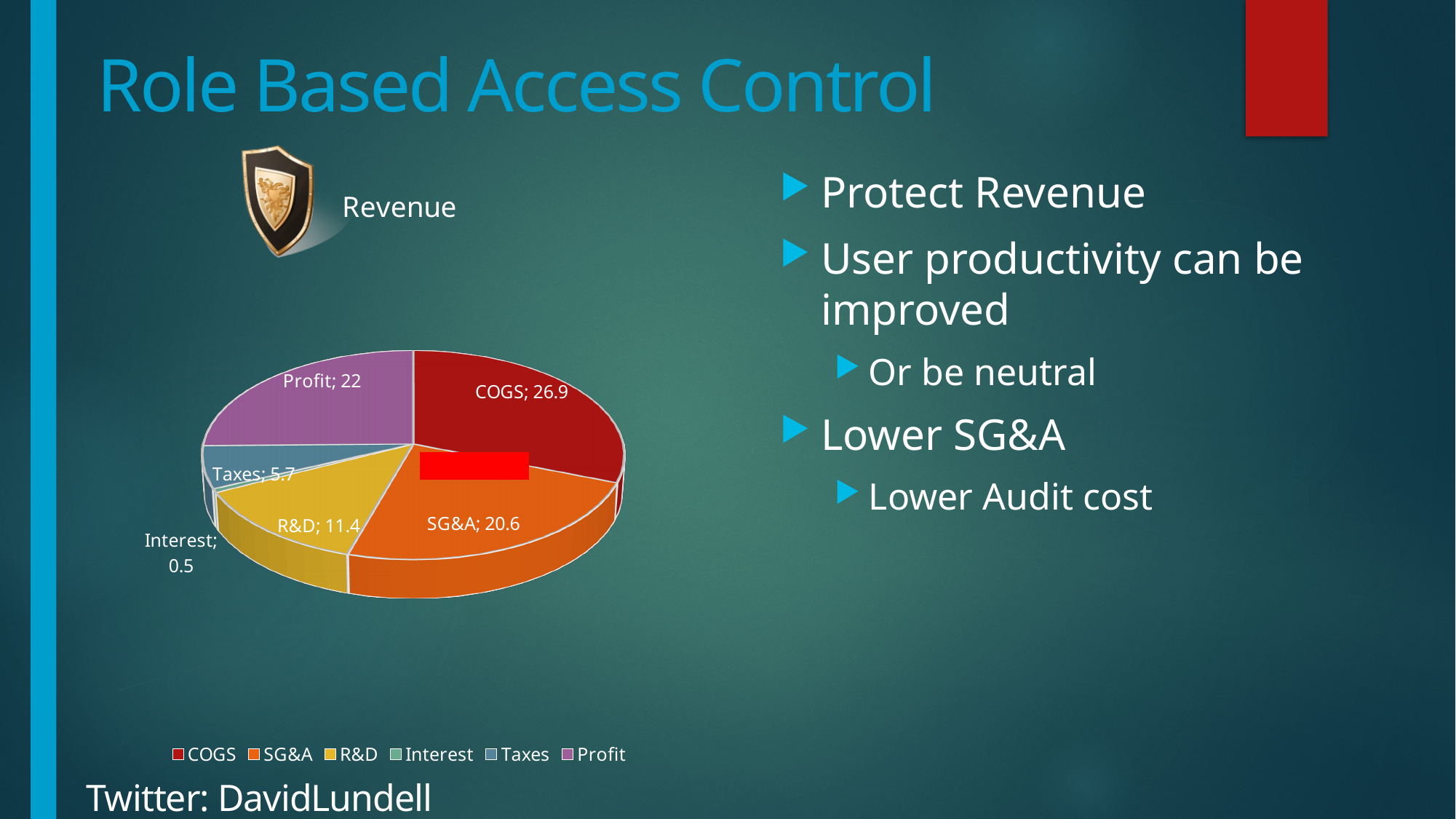
Which is larger in the Revenue pie chart, R&D or Taxes? R&D How many entries does the legend of the Revenue pie chart list? 6 What is the value of the Profit slice in the Revenue pie chart? 22 What is the value of the SG&A slice in the Revenue pie chart? 20.6 What is the difference between the COGS and SG&A values in the Revenue pie chart? 6.3 How many slices does the Revenue pie chart have? 6 Which slice of the Revenue pie chart has the smallest value? Interest What kind of chart is shown on the slide? pie chart What is the value of the COGS slice in the Revenue pie chart? 26.9 What is the title of the pie chart? Revenue What is the value of the Interest slice in the Revenue pie chart? 0.5 Which slice of the Revenue pie chart has the largest value? COGS